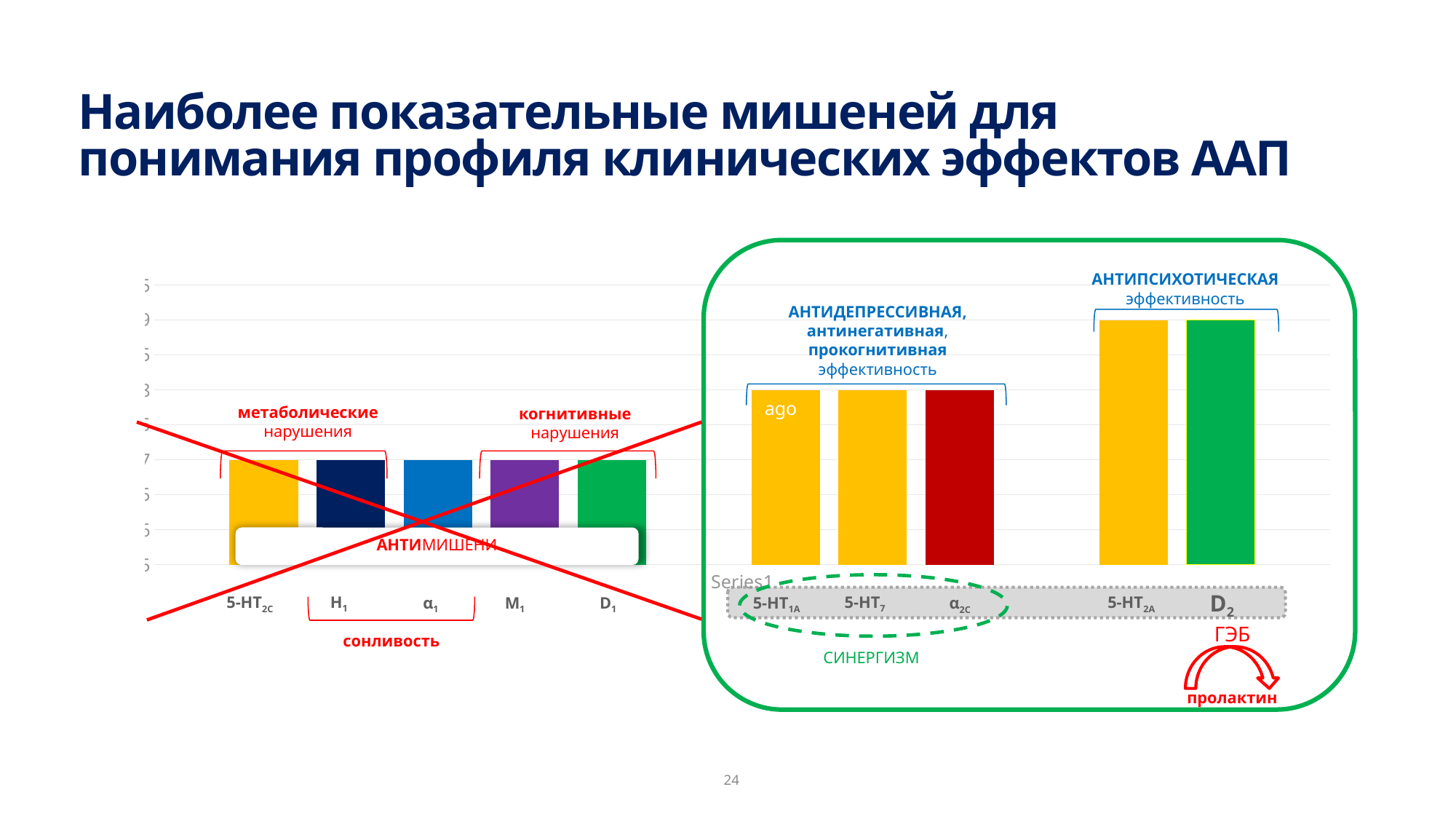
How many categories are enclosed in the green rounded box on the right side of the chart? 5 Which bar is taller, 5-HT2A or 5-HT2C? 5-HT2A Which bar is taller, α2C or M1? α2C What label is written inside the 5-HT1A bar? ago Which bar is taller, 5-HT1A or D1? 5-HT1A Which two categories have the tallest bars in the chart? 5-HT2A and D2 What kind of chart is shown on the slide? bar chart How many categories (receptor targets) are shown along the x axis of the chart? 10 What colour is the bar for α2C? red